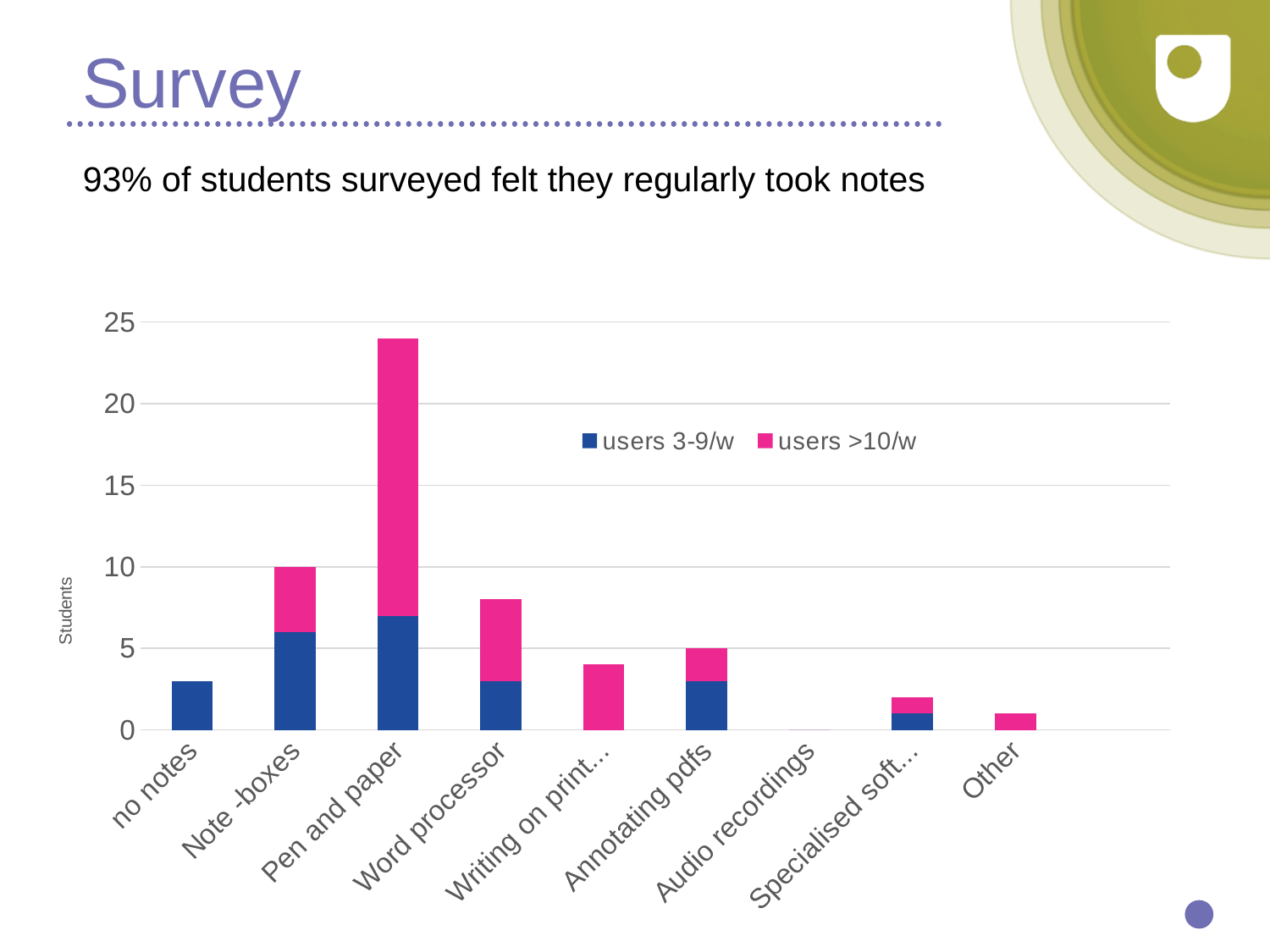
Is the bar for no notes greater or less than 5? less What is the label on the vertical axis? Students Which bar is taller, Note -boxes or Annotating pdfs? Note -boxes How many categories are shown on the x axis? 9 Which category has the shortest bar? Audio recordings What are the two series named in the legend? users 3-9/w and users >10/w Is the total bar for Pen and paper greater or less than 20? greater How many series does the legend list? 2 Is the total bar for Word processor greater or less than 10? less Which category has the tallest bar? Pen and paper What kind of chart is shown on the slide? stacked bar chart Which bar is taller, Pen and paper or Word processor? Pen and paper